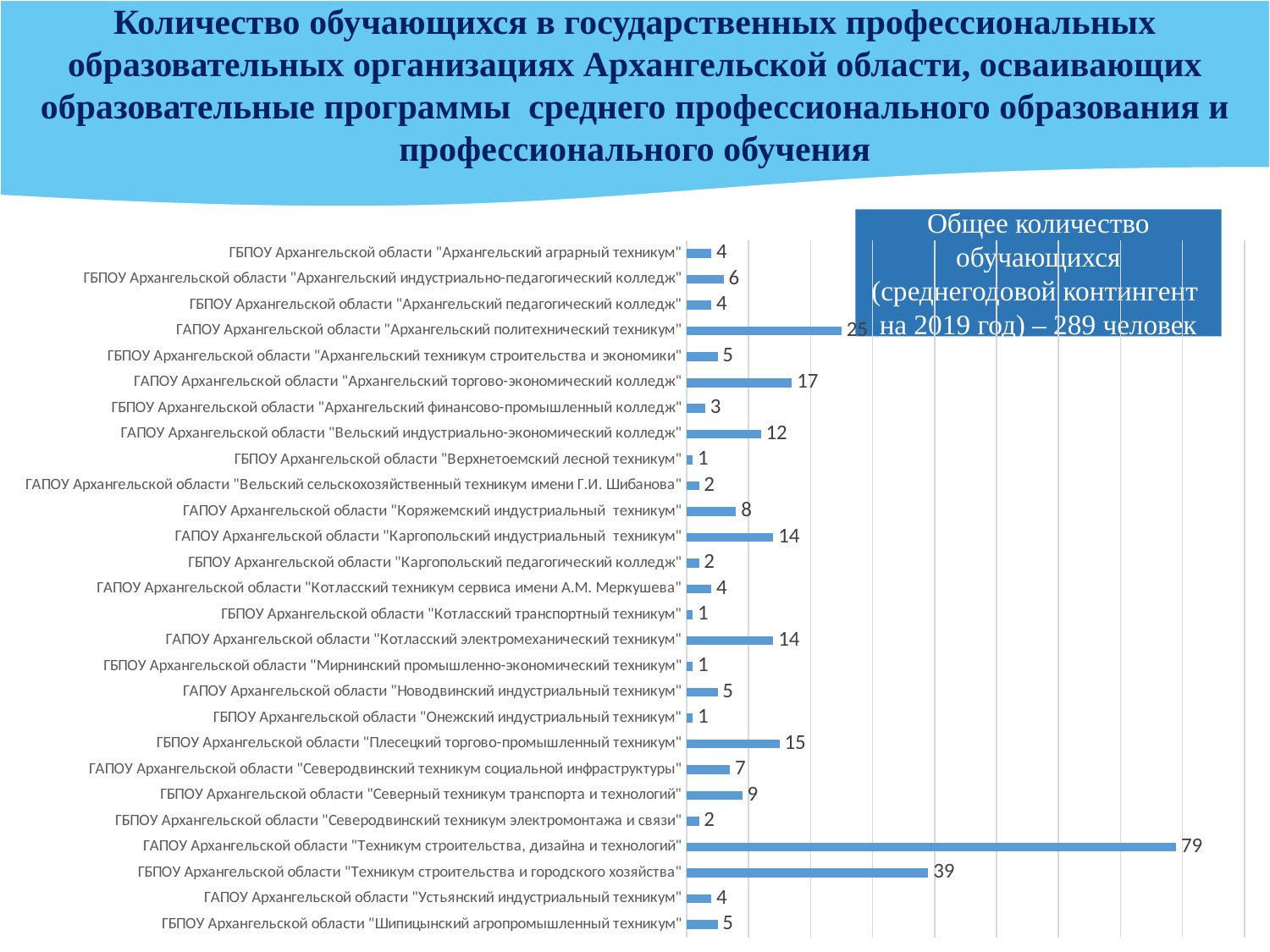
What type of chart is shown on the slide? bar chart According to the text box on the slide, what is the total number of students (average annual contingent for 2019)? 289 человек What is the value for ГАПОУ Архангельской области "Архангельский торгово-экономический колледж"? 17 Which has a larger value: "Архангельский политехнический техникум" or "Архангельский торгово-экономический колледж"? Архангельский политехнический техникум Which organisation has the highest value in the chart? ГАПОУ Архангельской области "Техникум строительства, дизайна и технологий" What is the value for ГАПОУ Архангельской области "Техникум строительства, дизайна и технологий"? 79 What is the difference between the values for "Вельский индустриально-экономический колледж" and "Коряжемский индустриальный техникум"? 4 What is the value for ГАПОУ Архангельской области "Архангельский политехнический техникум"? 25 What is the value for ГБПОУ Архангельской области "Техникум строительства и городского хозяйства"? 39 How many organisations (categories) are shown in the chart? 27 What is the difference between the values for "Техникум строительства, дизайна и технологий" and "Техникум строительства и городского хозяйства"? 40 What is the value for ГБПОУ Архангельской области "Плесецкий торгово-промышленный техникум"? 15